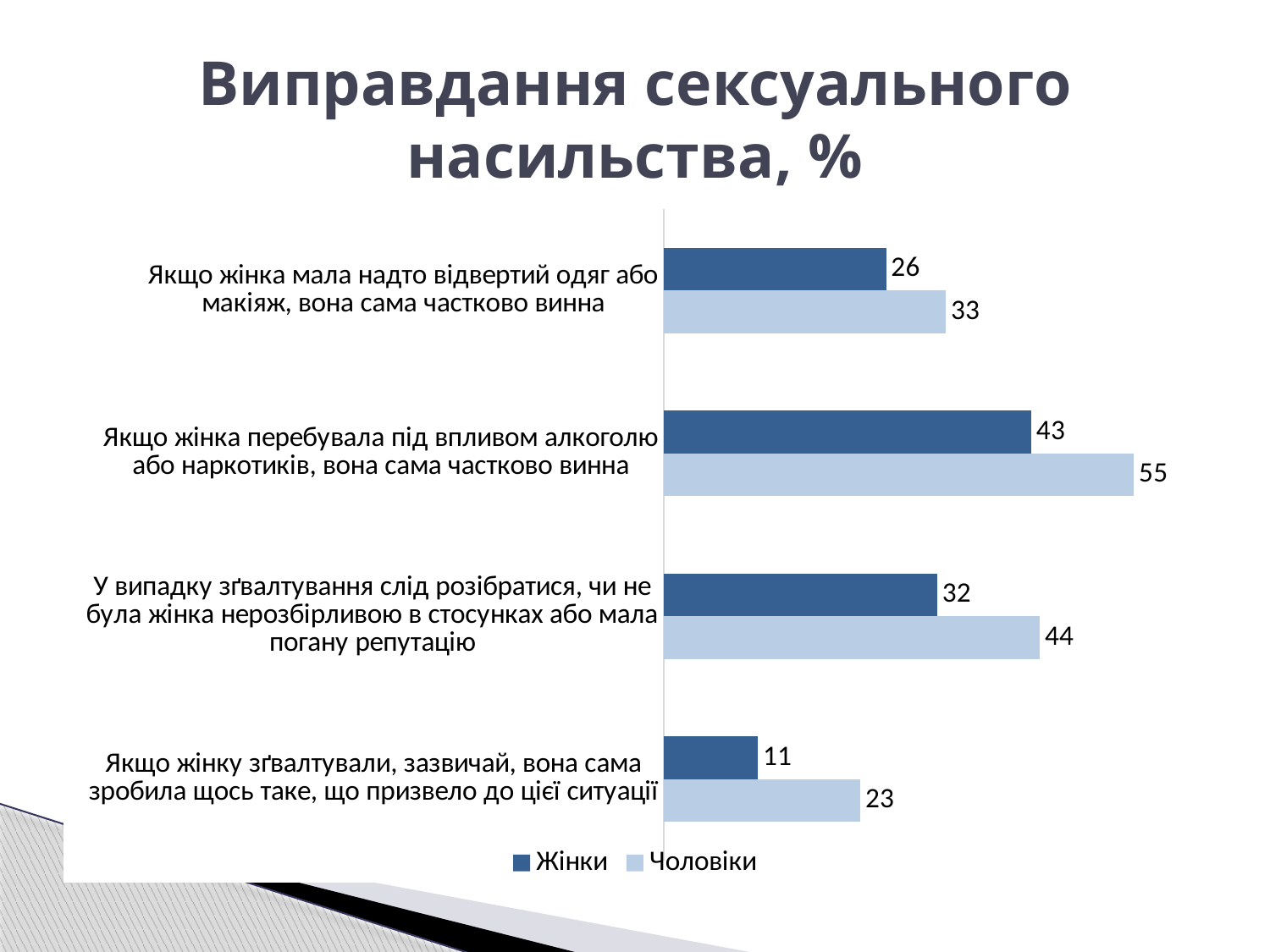
What type of chart is shown on the slide? Bar chart What is the title of the chart on the slide? Виправдання сексуального насильства, % What is the value for Жінки for the statement "Якщо жінка мала надто відвертий одяг або макіяж, вона сама частково винна"? 26 What is the value for Жінки for the statement "Якщо жінку зґвалтували, зазвичай, вона сама зробила щось таке, що призвело до цієї ситуації"? 11 What is the value for Чоловіки for the statement "Якщо жінка перебувала під впливом алкоголю або наркотиків, вона сама частково винна"? 55 How many statements (categories) are shown in the chart? 4 What is the difference between the Чоловіки and Жінки values for the statement "Якщо жінка перебувала під впливом алкоголю або наркотиків, вона сама частково винна"? 12 What is the value for Чоловіки for the statement "У випадку зґвалтування слід розібратися, чи не була жінка нерозбірливою в стосунках або мала погану репутацію"? 44 Which statement has the lowest value for Жінки? Якщо жінку зґвалтували, зазвичай, вона сама зробила щось таке, що призвело до цієї ситуації Which statement has the highest value for Чоловіки? Якщо жінка перебувала під впливом алкоголю або наркотиків, вона сама частково винна For the statement "Якщо жінка мала надто відвертий одяг або макіяж, вона сама частково винна", which series has the larger value, Жінки or Чоловіки? Чоловіки How many series does the legend list? 2